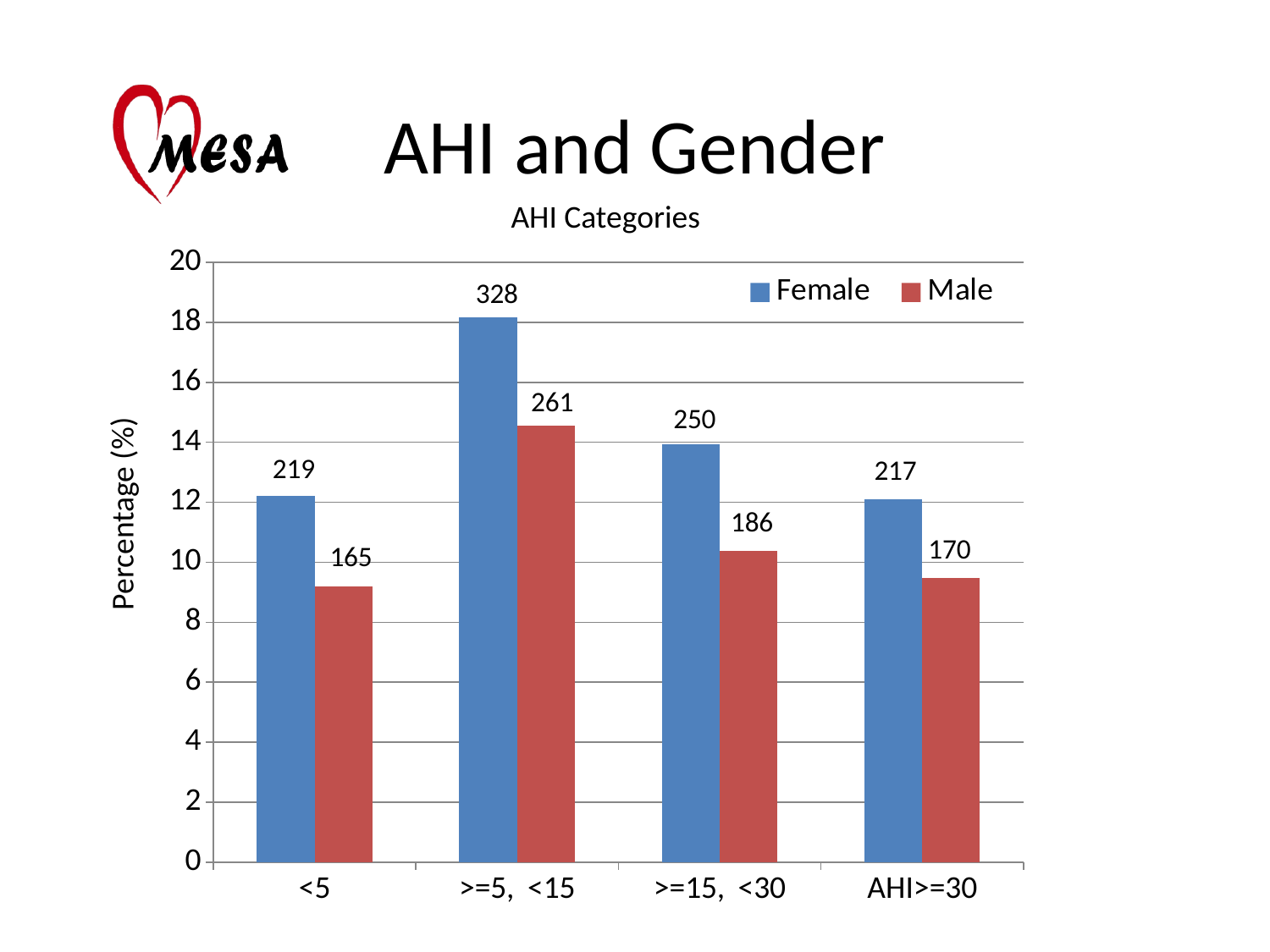
How many AHI categories are shown on the x axis? 4 What is the data label on the Female bar for the >=5, <15 category? 328 Which AHI category has the tallest Female bar? >=5, <15 How many series does the legend list? 2 Which AHI category has the shortest Male bar? <5 What is the data label on the Male bar for the AHI>=30 category? 170 Is the Male bar for the >=5, <15 category greater or less than 14 on the percentage axis? greater What is the difference between the Female and Male data labels in the >=15, <30 category? 64 What is the title of the chart? AHI Categories What is the data label on the Male bar for the <5 category? 165 Is the Male bar for the <5 category greater or less than 10 on the percentage axis? less What type of chart is shown on the slide? bar chart